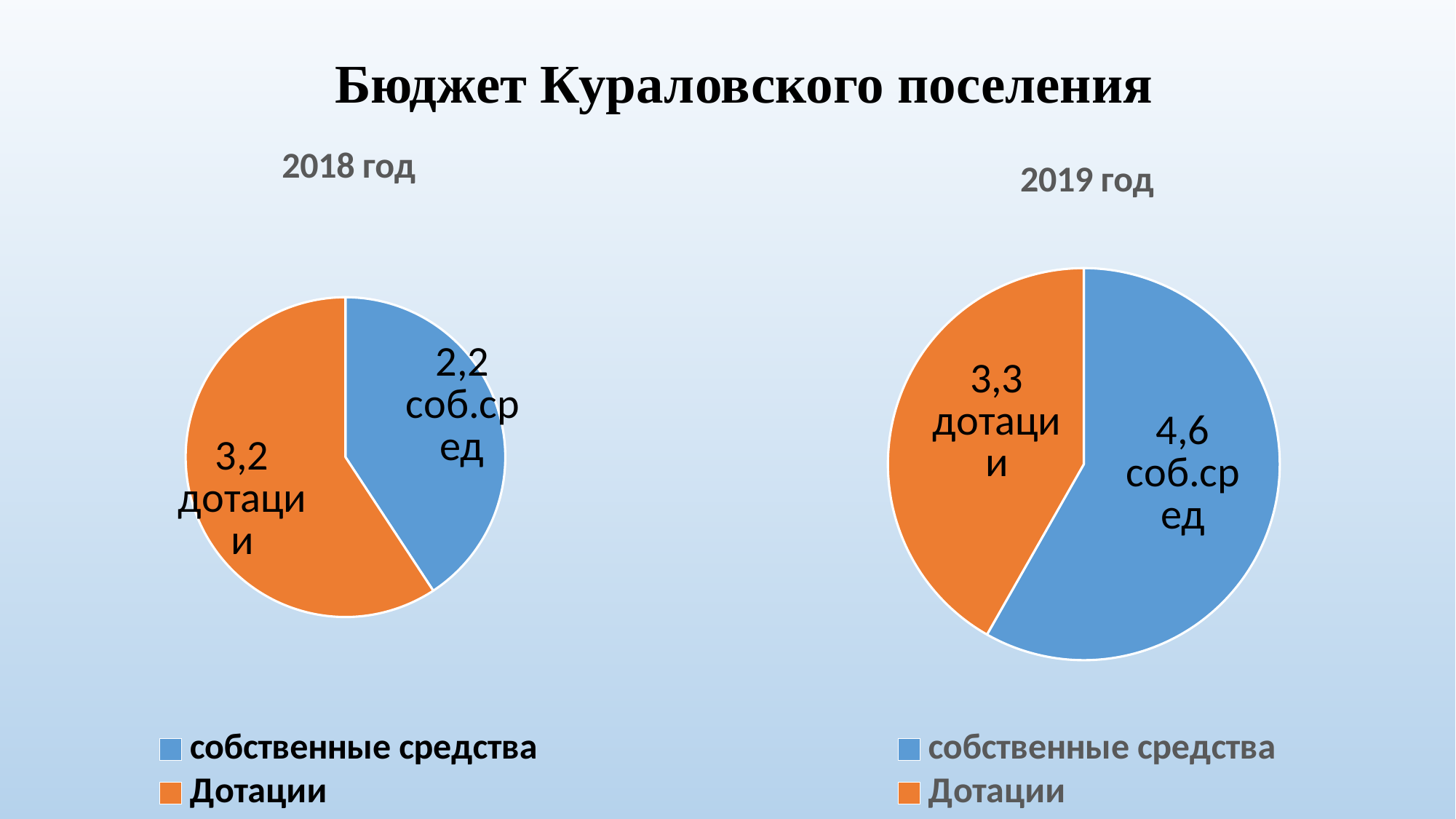
In the 2019 год chart, what is the value for собственные средства? 4,6 In the 2018 год chart, which slice is the largest? Дотации In the 2019 год chart, which slice is the smallest? Дотации In the 2018 год chart, what is the value for Дотации? 3,2 What type of chart is used for the 2018 год data? pie chart In the 2019 год chart, what is the value for Дотации? 3,3 In the 2018 год chart, which is larger: собственные средства or Дотации? Дотации What is the title of the slide containing the two pie charts? Бюджет Кураловского поселения In the 2019 год chart, what is the difference between собственные средства and Дотации? 1,3 In the 2018 год chart, what is the value for собственные средства? 2,2 How many slices does the 2019 год pie chart have? 2 How many entries does the legend of the 2018 год chart list? 2